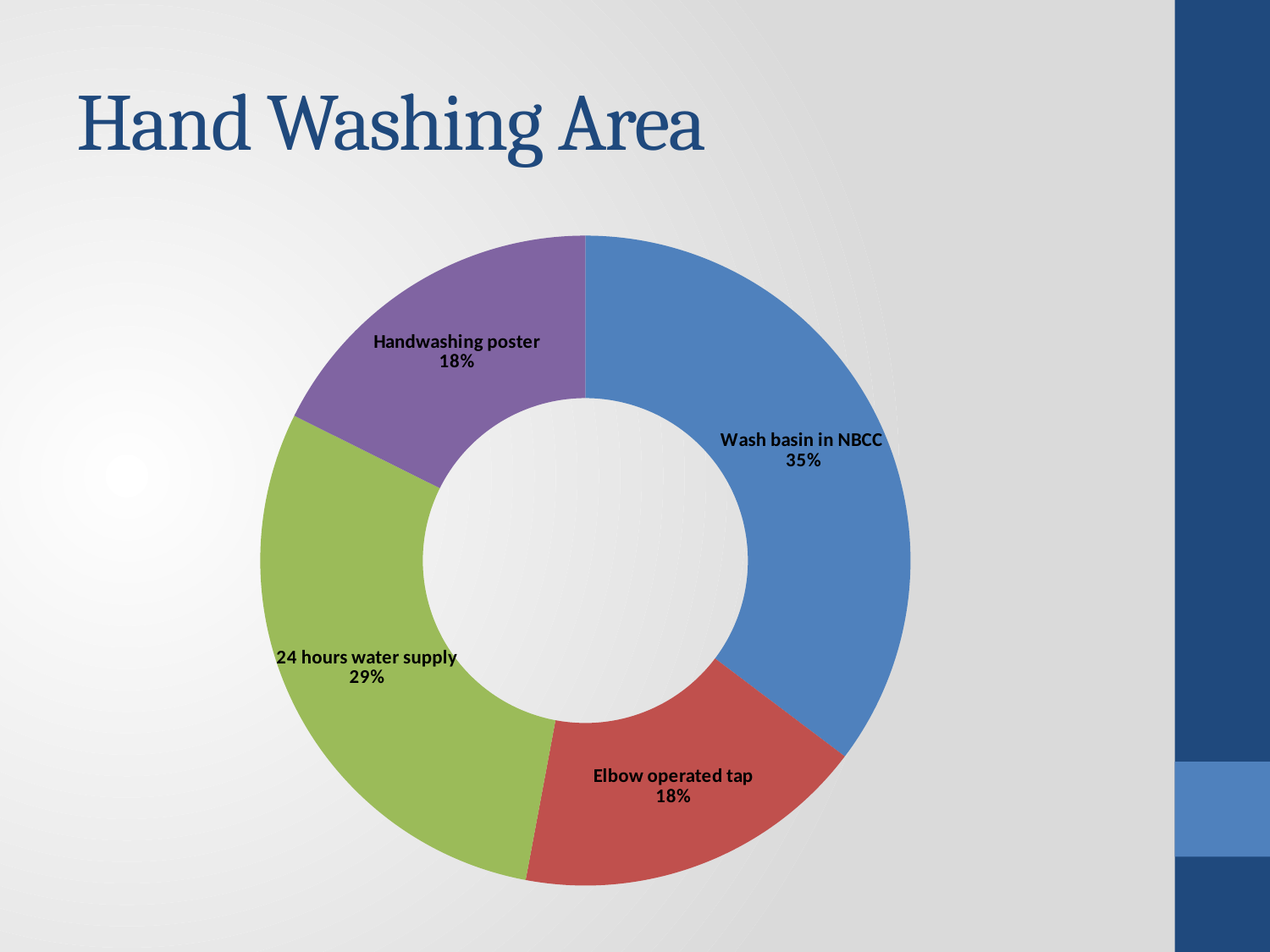
What is the difference in percentage points between 24 hours water supply and Elbow operated tap? 11 What percentage is shown for Handwashing poster? 18% What is the difference in percentage points between Wash basin in NBCC and 24 hours water supply? 6 What is the value shown for 24 hours water supply? 29% What percentage is shown for Elbow operated tap? 18% What kind of chart is shown on the slide? Doughnut chart Which is larger, the share for Wash basin in NBCC or the share for 24 hours water supply? Wash basin in NBCC What share of the chart does Wash basin in NBCC represent? 35% What is the title of the slide containing the chart? Hand Washing Area Which category has the largest share of the chart? Wash basin in NBCC How many categories are shown in the chart? 4 What colour is the segment for 24 hours water supply? Green